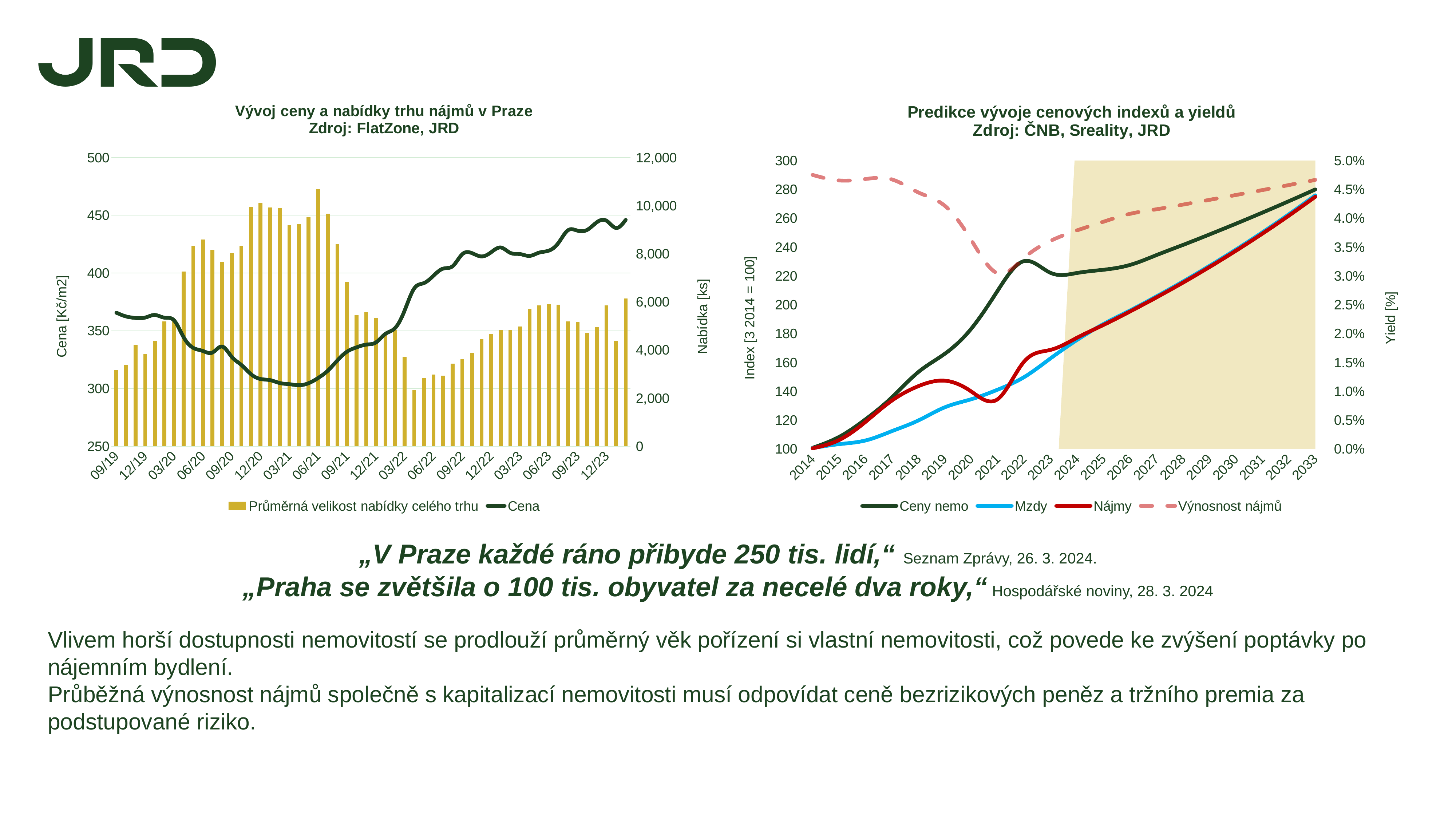
What kind of chart is the left chart, 'Vývoj ceny a nabídky trhu nájmů v Praze'? A combined bar and line chart In the left chart, is the bar for 06/22 (Průměrná velikost nabídky celého trhu) greater or less than 4,000? less In the left chart, is the Cena value for 06/21 greater or less than 350? less How many series does the legend of the left chart list? 2 In the left chart, is the Cena value for 12/23 greater or less than 400? greater In the right chart, does the Mzdy series rise or fall from 2014 to 2033? Rises How many series does the legend of the right chart list? 4 What kind of chart is the right chart, 'Predikce vývoje cenových indexů a yieldů'? Line chart In the right chart, which is larger in 2019: Nájmy or Mzdy? Nájmy In the right chart, how many years are shown on the x axis? 20